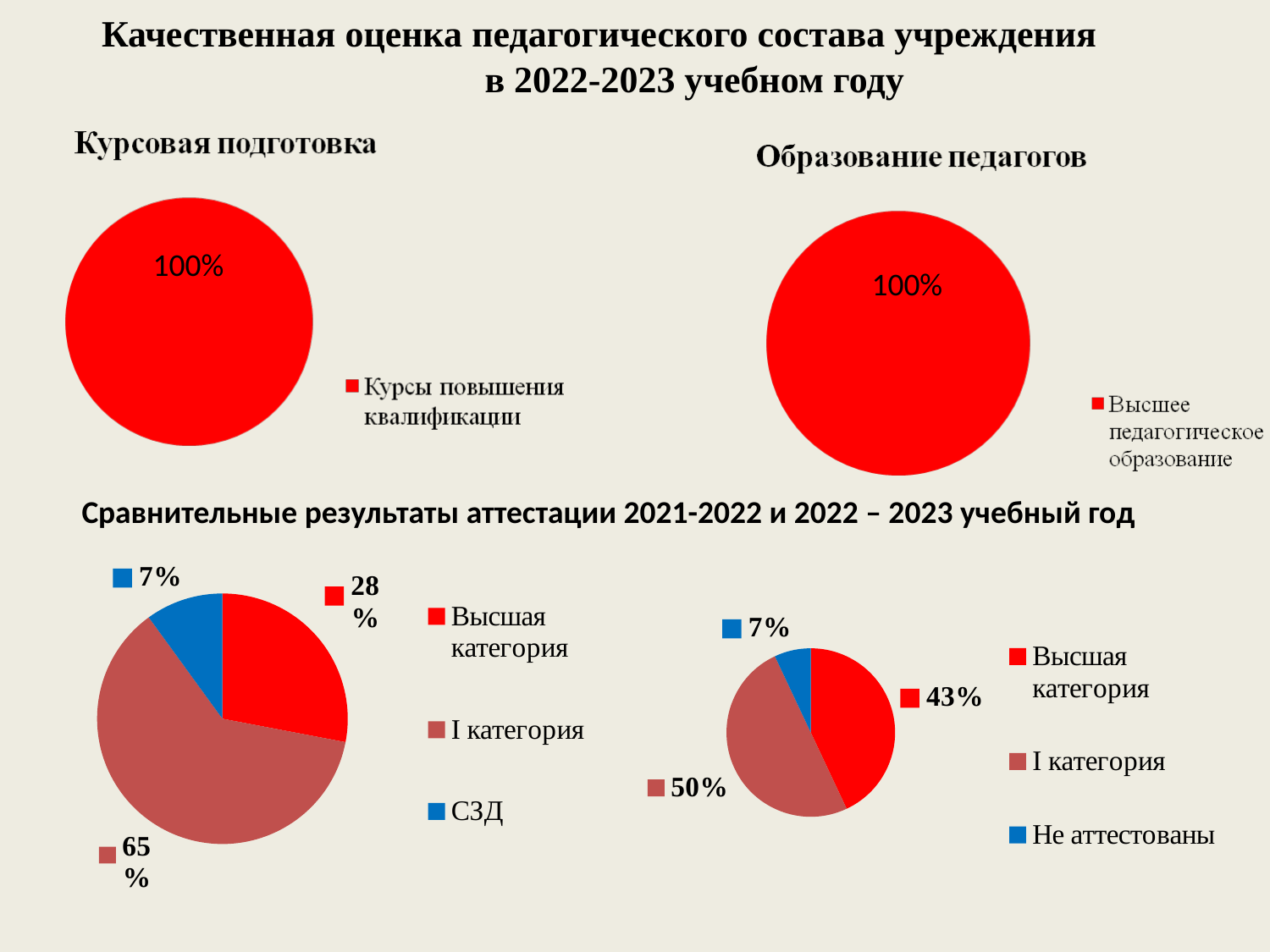
In the bottom-left pie chart, what is the value for 'СЗД'? 7% In the bottom-left pie chart, what is the value for 'Высшая категория'? 28% In the bottom-left pie chart, what is the value for 'I категория'? 65% In the bottom-right pie chart, what is the value for 'Высшая категория'? 43% In the bottom-right pie chart, what is the difference between the values for 'I категория' and 'Высшая категория'? 7% What kind of chart is the top-left chart titled 'Курсовая подготовка'? pie chart In the top-right chart titled 'Образование педагогов', what value is shown for 'Высшее педагогическое образование'? 100% In the bottom-right pie chart, which category has the largest share? I категория In the bottom-left pie chart, which category has the smallest share? СЗД In the bottom-right pie chart, what is the value for 'Не аттестованы'? 7% How many entries does the legend of the bottom-right pie chart list? 3 In the top-left chart titled 'Курсовая подготовка', what value is shown for 'Курсы повышения квалификации'? 100%